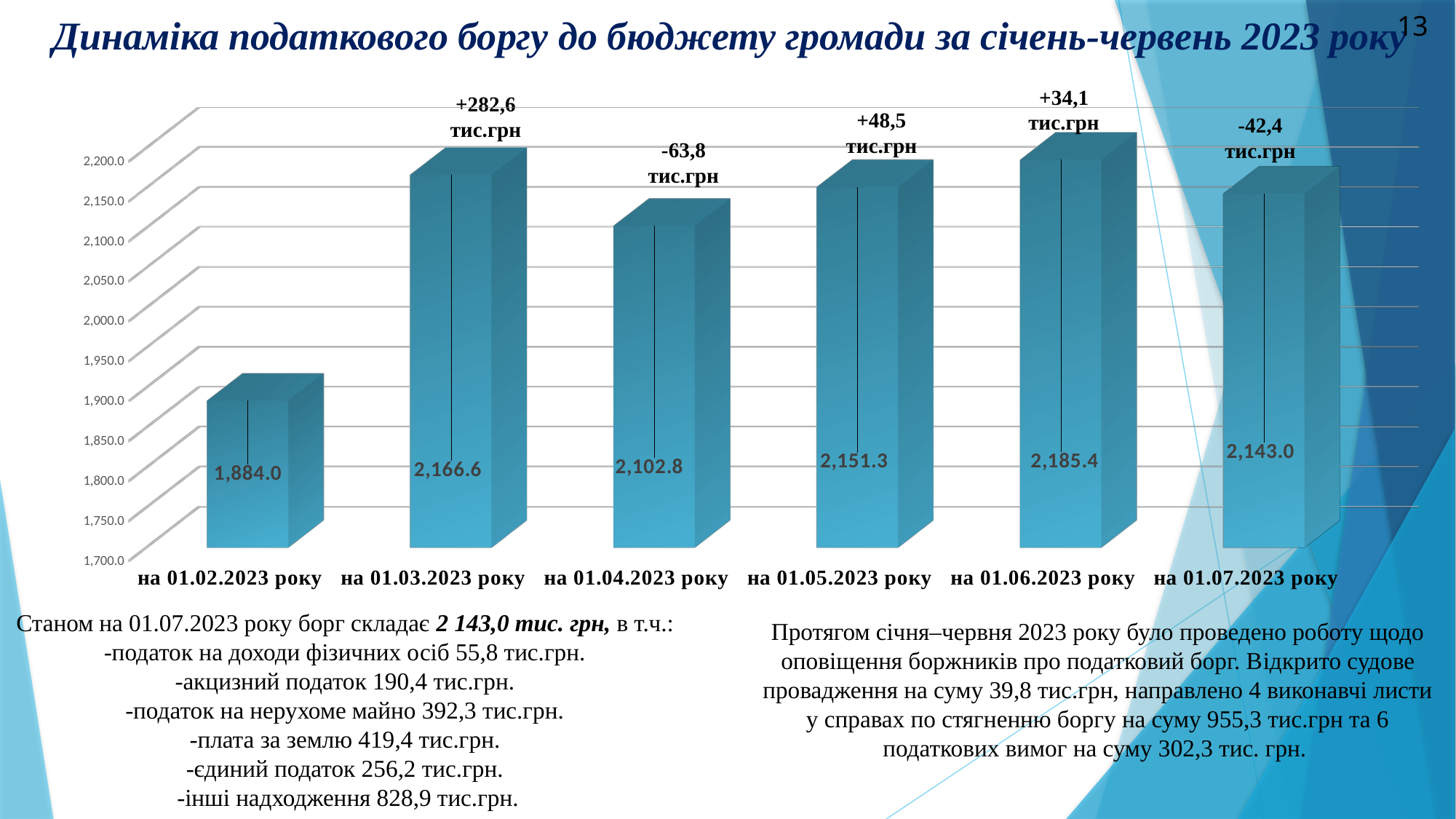
Is the value for на 01.02.2023 року greater or less than 2,000.0? less What kind of chart is shown on the slide? bar chart What is the value for на 01.02.2023 року? 1,884.0 What is the difference between the values for на 01.03.2023 року and на 01.02.2023 року? 282.6 Which date has the highest value? на 01.06.2023 року What is the value for на 01.04.2023 року? 2,102.8 How many dates (bars) are shown in the chart? 6 What is the value for на 01.06.2023 року? 2,185.4 Which is larger, the value for на 01.05.2023 року or на 01.04.2023 року? на 01.05.2023 року What is the title of the slide's chart? Динаміка податкового боргу до бюджету громади за січень-червень 2023 року Which date has the lowest value? на 01.02.2023 року What is the value for на 01.07.2023 року? 2,143.0